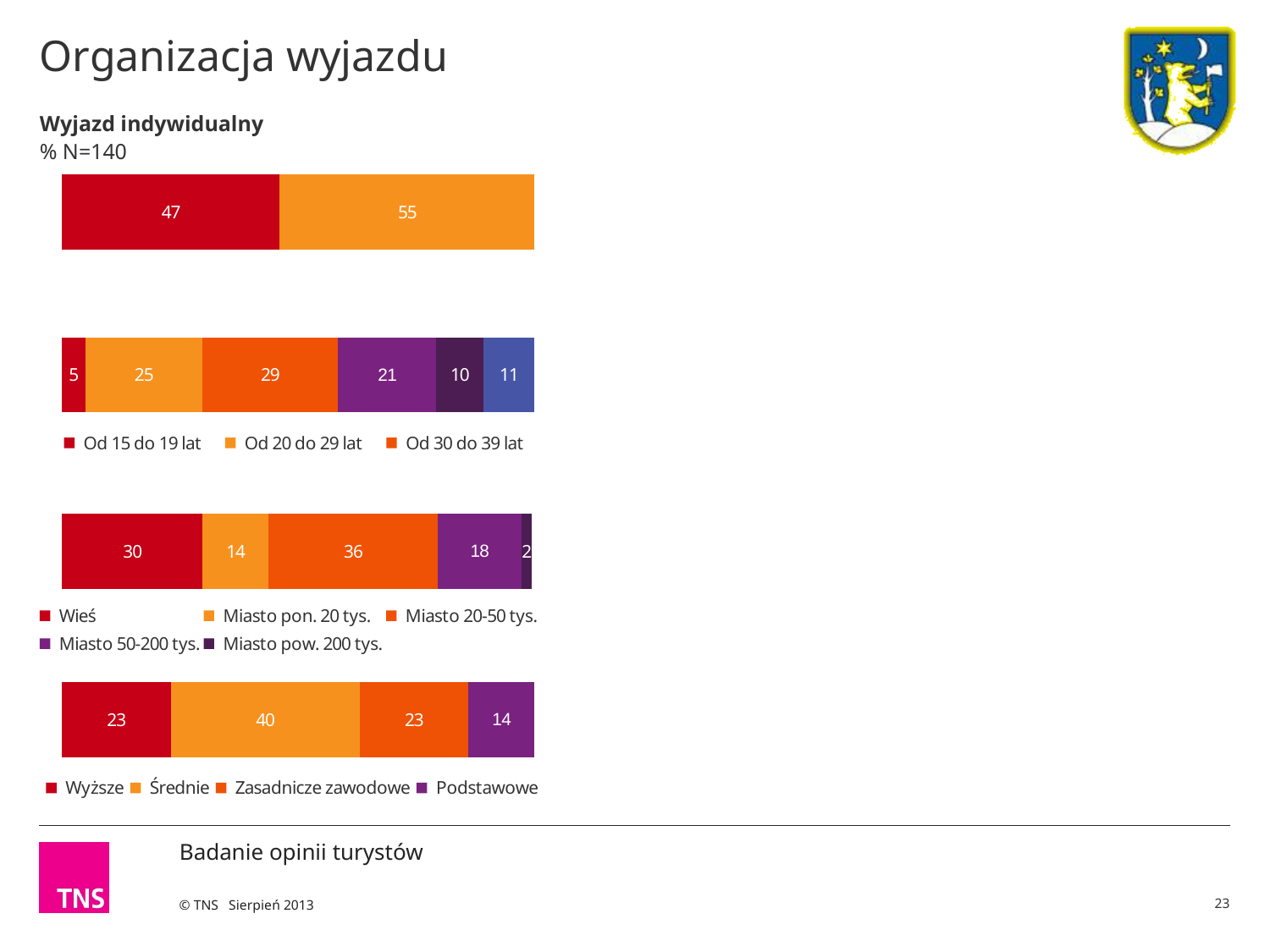
In the topmost bar chart, what is the value of the orange segment? 55 What kind of chart is the bottom chart (education)? Stacked bar chart In the third chart from the top (place of residence), what is the value for "Miasto 20-50 tys."? 36 In the third chart from the top (place of residence), what is the difference between "Wieś" and "Miasto pon. 20 tys."? 16 In the topmost bar chart (just below "% N=140"), what is the value of the first (red) segment? 47 In the third chart from the top (place of residence), which category has the lowest value? Miasto pow. 200 tys. In the second chart from the top (age groups), what is the value for "Od 20 do 29 lat"? 25 In the bottom chart (education), which category has the highest value? Średnie In the topmost bar chart, what is the total of the two segments? 102 In the second chart from the top (age groups), what is the value for "Od 30 do 39 lat"? 29 In the second chart from the top (age groups), what is the value for "Od 15 do 19 lat"? 5 In the bottom chart (education), how many series does the legend list? 4